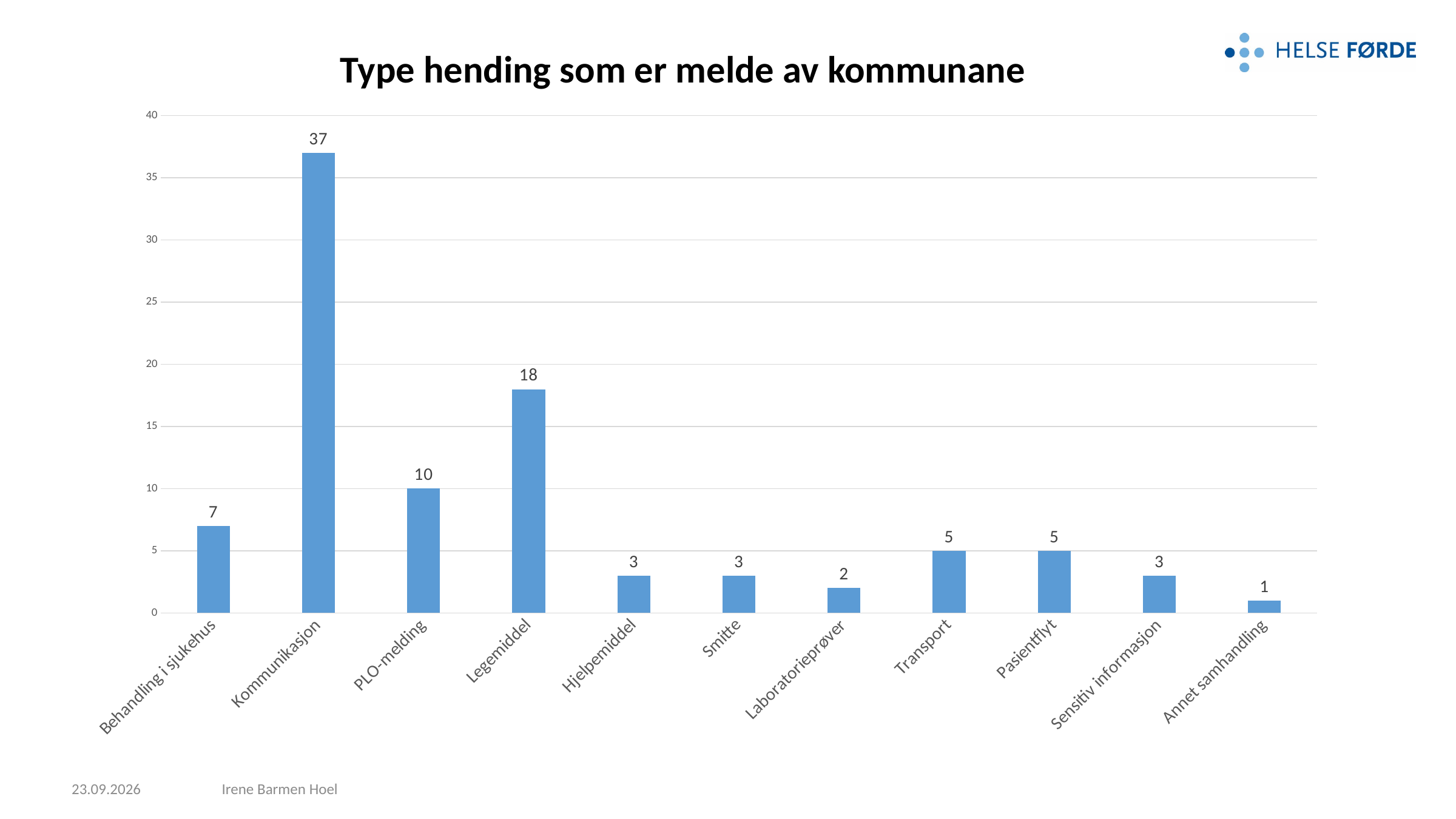
Which is larger, the value for PLO-melding or the value for Behandling i sjukehus? PLO-melding What is the value for Behandling i sjukehus? 7 What is the value for Laboratorieprøver? 2 What is the value for Legemiddel? 18 What kind of chart is shown on the slide? Bar chart Which category has the highest value? Kommunikasjon What is the difference between the values for Kommunikasjon and Legemiddel? 19 What is the value for Kommunikasjon? 37 Which category has the lowest value? Annet samhandling How many categories are shown on the x axis? 11 What is the title of the chart? Type hending som er melde av kommunane Is the value for Legemiddel greater or less than 15? greater